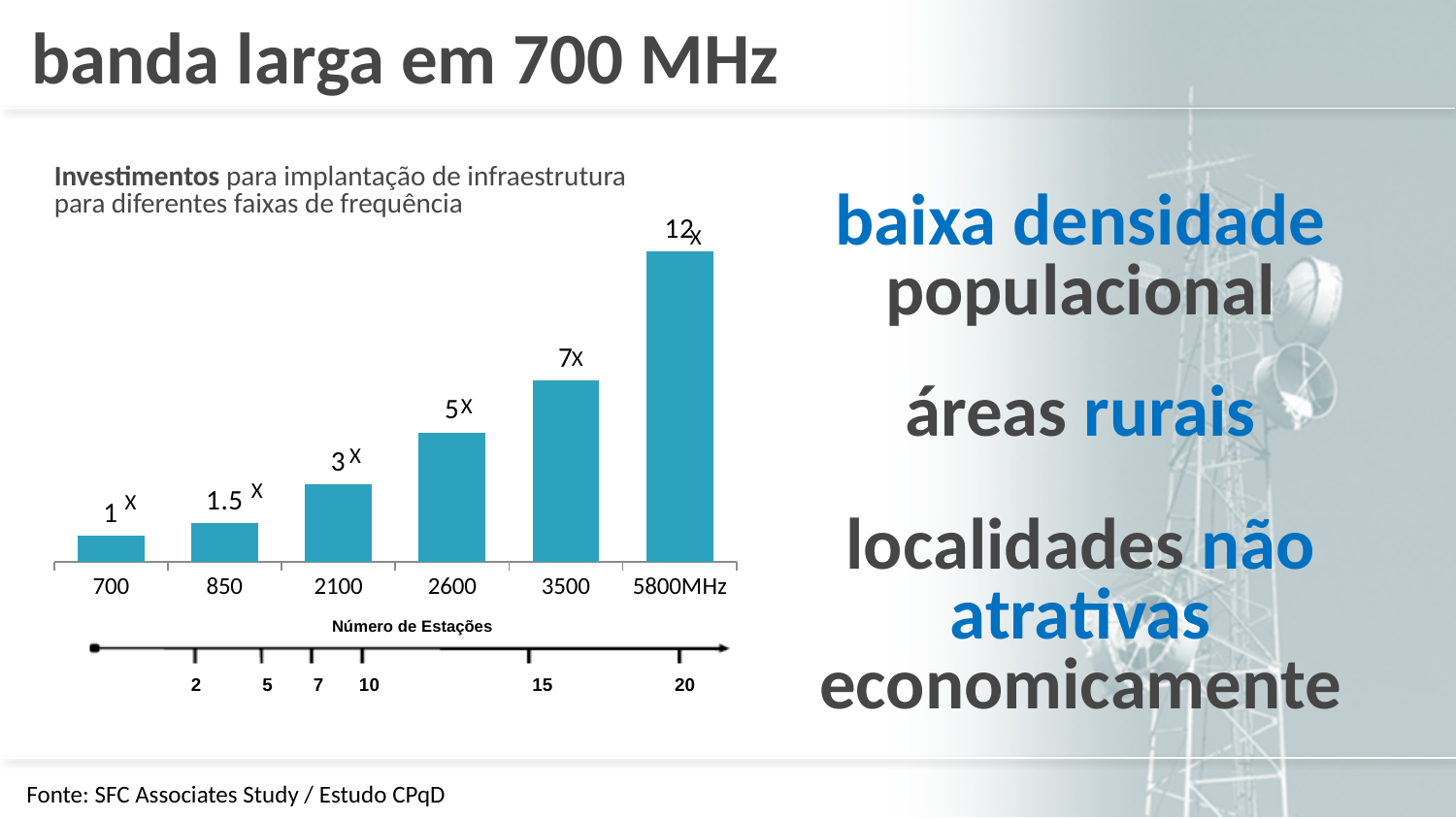
What kind of chart is used to show the investments by frequency band? Bar chart Which frequency band has the lowest investment value? 700 What is the investment value shown for the 850 MHz band? 1.5x Which has a larger investment value, 2600 or 3500? 3500 Which frequency band has the highest investment value? 5800MHz What is the investment value shown for the 2100 MHz band? 3x What is the investment value shown for the 3500 MHz band? 7x What is the difference between the investment values for 5800MHz and 2600? 7x Do the investment values rise or fall as the frequency increases along the x axis? Rise How many frequency bands are shown in the chart? 6 What is the investment value shown for the 700 MHz band? 1x What is the label of the axis shown below the bar chart? Número de Estações